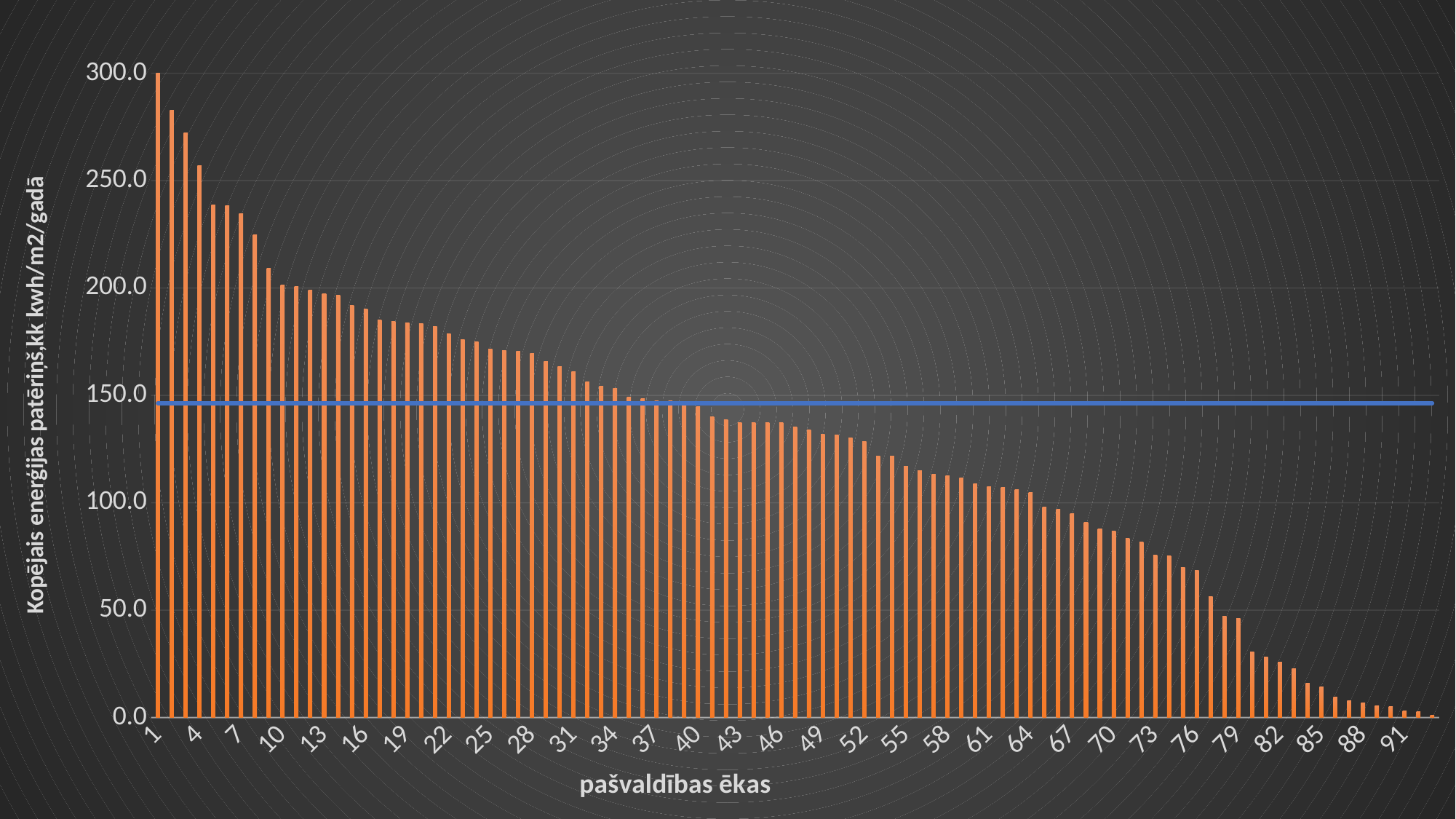
What kind of chart is shown on the slide? combination bar and line chart Is the value for building 31 greater or less than 150? greater Is the value for building 82 greater or less than 50? less Is the value for building 1 greater or less than 250? greater Do the bar values rise or fall as you move from left to right along the x axis? fall Which has the larger value, building 4 or building 7? building 4 What colour is the horizontal line drawn across the chart? blue Which building number has the highest energy consumption? 1 What is the title of the x axis? pašvaldības ēkas